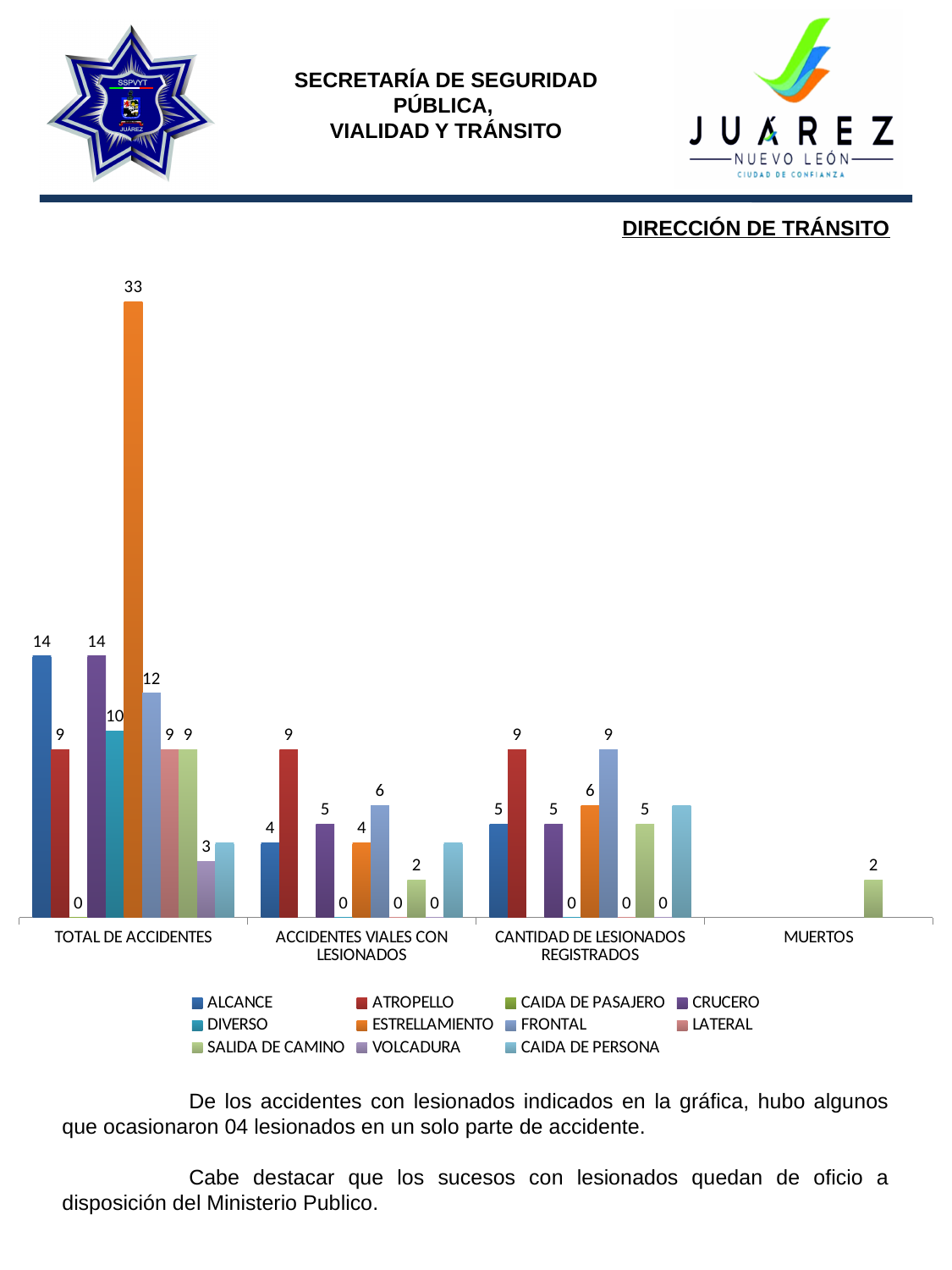
In the ACCIDENTES VIALES CON LESIONADOS category, which is larger: ATROPELLO or CRUCERO? ATROPELLO What is the difference between ESTRELLAMIENTO and ALCANCE in the TOTAL DE ACCIDENTES category? 19 What is the value for FRONTAL in the TOTAL DE ACCIDENTES category? 12 What kind of chart is shown on the slide? Bar chart What is the value for SALIDA DE CAMINO in the MUERTOS category? 2 How many series does the legend list? 11 What is the value for ATROPELLO in the ACCIDENTES VIALES CON LESIONADOS category? 9 Which series has the highest value in the TOTAL DE ACCIDENTES category? ESTRELLAMIENTO What is the value for ESTRELLAMIENTO in the TOTAL DE ACCIDENTES category? 33 What is the value for DIVERSO in the TOTAL DE ACCIDENTES category? 10 What is the value for FRONTAL in the CANTIDAD DE LESIONADOS REGISTRADOS category? 9 How many categories are shown on the x axis? 4